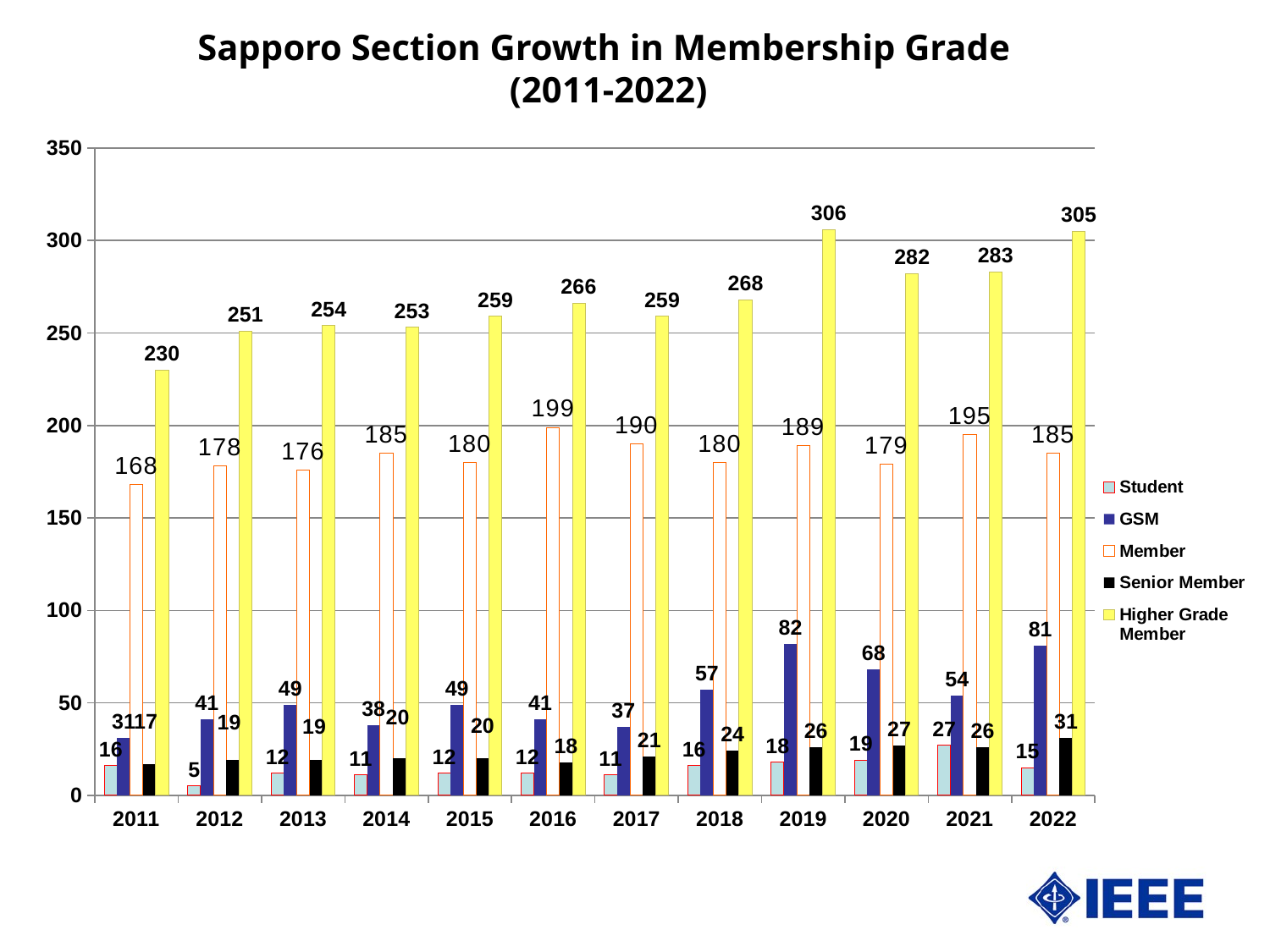
What is the Higher Grade Member value for 2011? 230 What is the GSM value for 2019? 82 In which year is the Member value highest? 2016 What is the Senior Member value for 2022? 31 Does the Higher Grade Member series generally rise or fall from 2011 to 2022? rise In which year is the Student value lowest? 2012 What is the Member value for 2016? 199 How many years are shown on the x axis? 12 Which is larger, the GSM value for 2020 or the GSM value for 2021? 2020 How many series does the legend list? 5 What type of chart is shown on the slide? bar chart What is the difference between the Higher Grade Member values for 2022 and 2011? 75